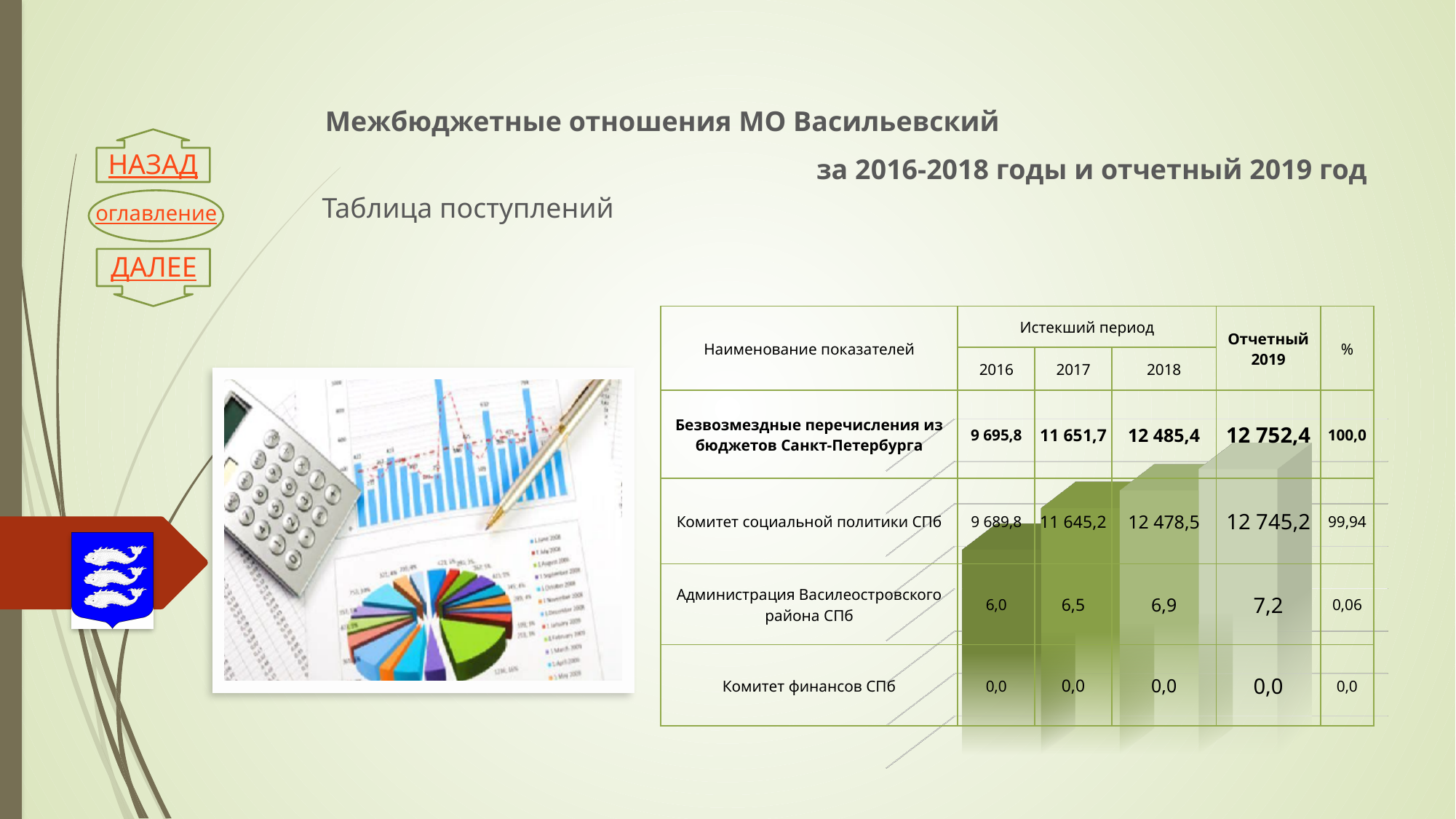
In the table, what is the value for 'Администрация Василеостровского района СПб' in 2018? 6,9 Which bar in the green bar chart is the tallest, the leftmost or the rightmost? rightmost In the table, what is the difference between the 2019 and 2018 values for 'Администрация Василеостровского района СПб'? 0,3 What kind of chart is drawn behind the table on the right side of the slide? bar chart What is the title of the table shown on the slide? Таблица поступлений In the table, what percentage share is shown for 'Комитет социальной политики СПб'? 99,94 In the table, which is larger: the 2017 value or the 2018 value of 'Безвозмездные перечисления из бюджетов Санкт-Петербурга'? 2018 Do the bars in the green bar chart rise or fall from left to right? rise How many bars does the green bar chart behind the table contain? 4 In the table, what is the value for 'Комитет социальной политики СПб' in 2016? 9 689,8 Which bar in the green bar chart is the shortest, the leftmost or the rightmost? leftmost In the table, what is the value of 'Безвозмездные перечисления из бюджетов Санкт-Петербурга' for the reporting year 2019? 12 752,4